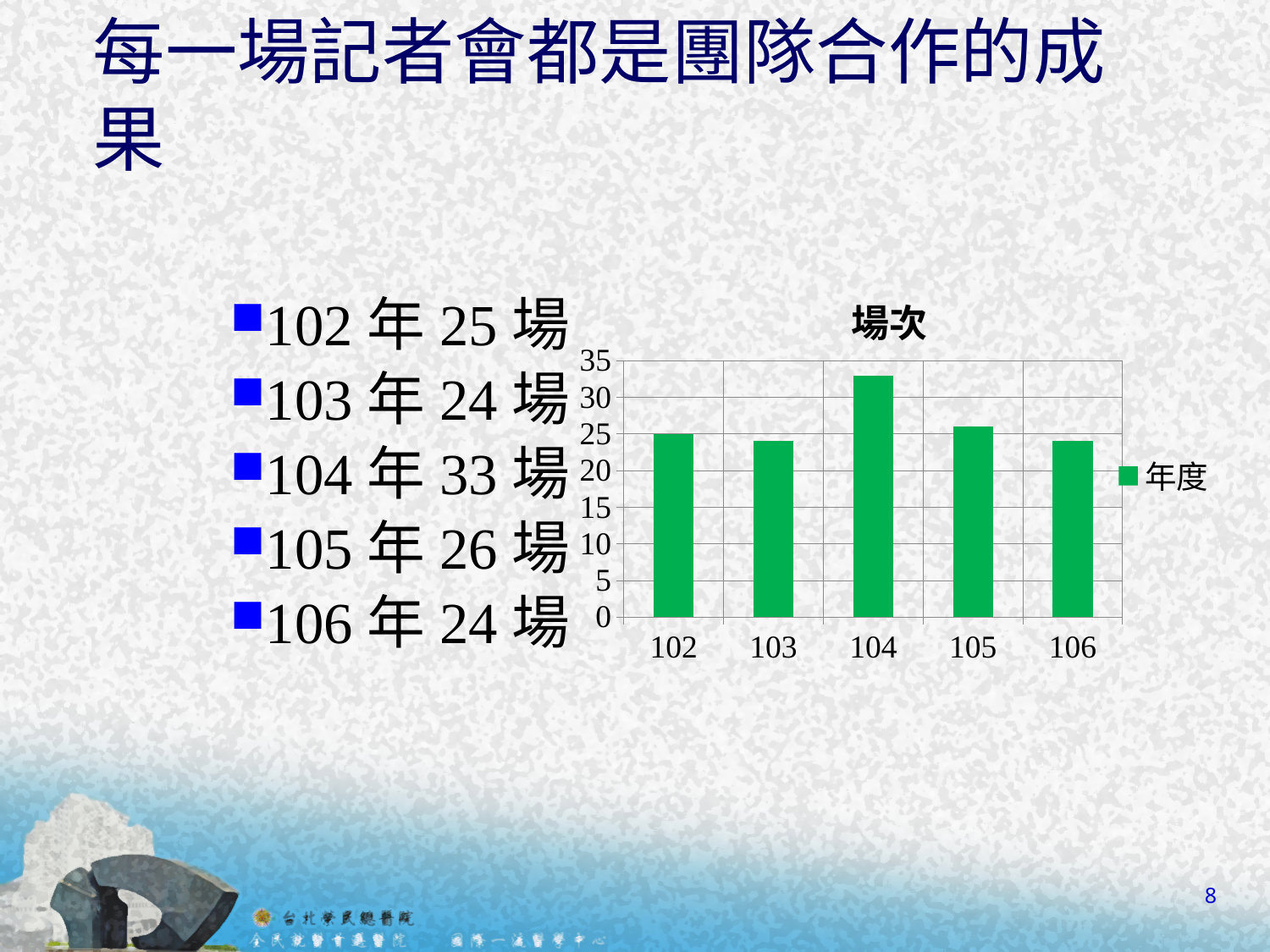
Is the value for year 104 greater or less than 30? greater How many series does the chart legend list? 1 What type of chart is shown on the slide? bar chart Which year has the highest value in the chart? 104 What is the value for year 105 in the chart? 26 What is the legend entry for the series in the chart? 年度 What is the difference between the values for year 104 and year 102? 8 Which is larger, the value for year 104 or the value for year 105? 104 What is the value for year 104 in the chart? 33 What is the title of the chart? 場次 What is the value for year 102 in the chart? 25 How many categories are shown on the x axis of the chart? 5